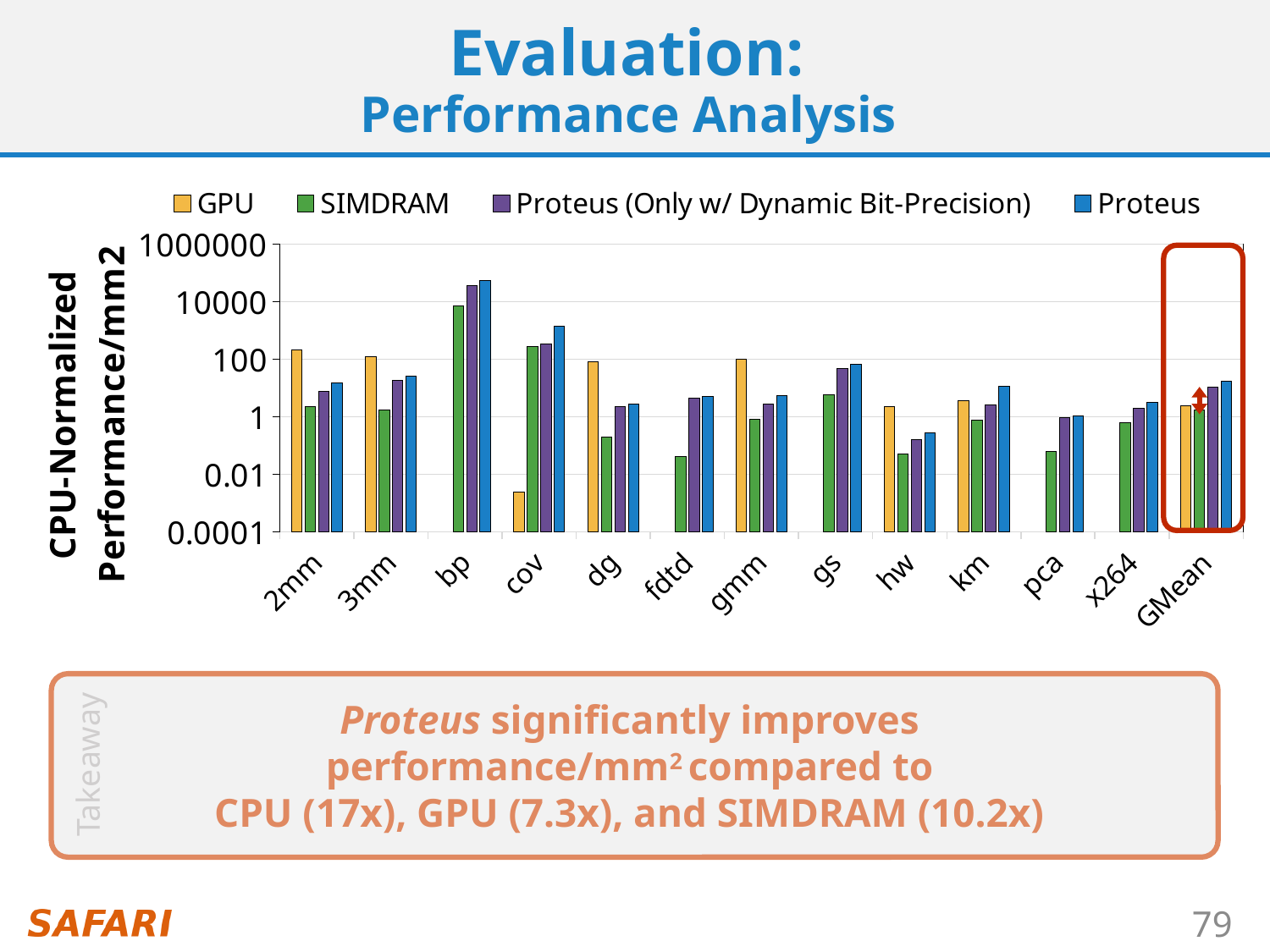
Which category on the x axis is highlighted with a red box? GMean Is the SIMDRAM value for fdtd greater or less than 0.1? less Which category has the lowest GPU bar? cov What kind of chart is shown on the slide? bar chart Is the Proteus value for cov greater or less than 100? greater Is the GPU value for cov greater or less than 0.01? less How many categories are shown along the x axis? 13 For 2mm, which is larger: the GPU bar or the SIMDRAM bar? GPU Which category has the highest Proteus bar? bp For cov, which is larger: the GPU bar or the Proteus bar? Proteus How many series does the legend list? 4